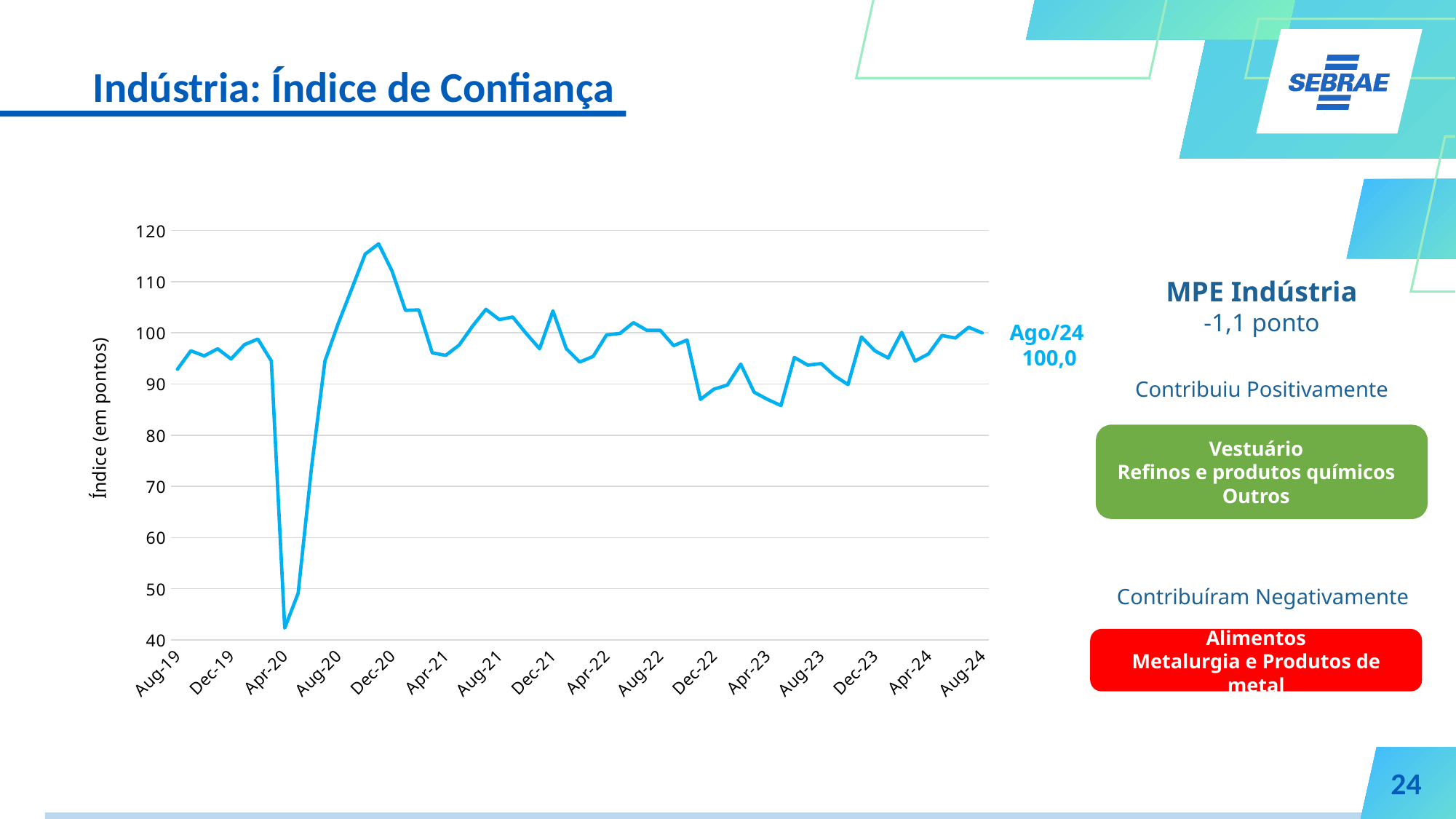
How many labels are shown on the x axis? 16 Does the line rise or fall between Apr-20 and Dec-20? rise Is the value at Dec-20 greater or less than 110? greater Which x-axis label corresponds to the lowest point of the line? Apr-20 Is the value at Aug-19 greater or less than 90? greater What is the value of the index labelled for Ago/24? 100,0 What kind of chart is shown on the slide? line chart Is the value at Apr-20 greater or less than 50? less Does the line rise or fall between Dec-20 and Apr-21? fall What is the title of the y axis? Índice (em pontos)